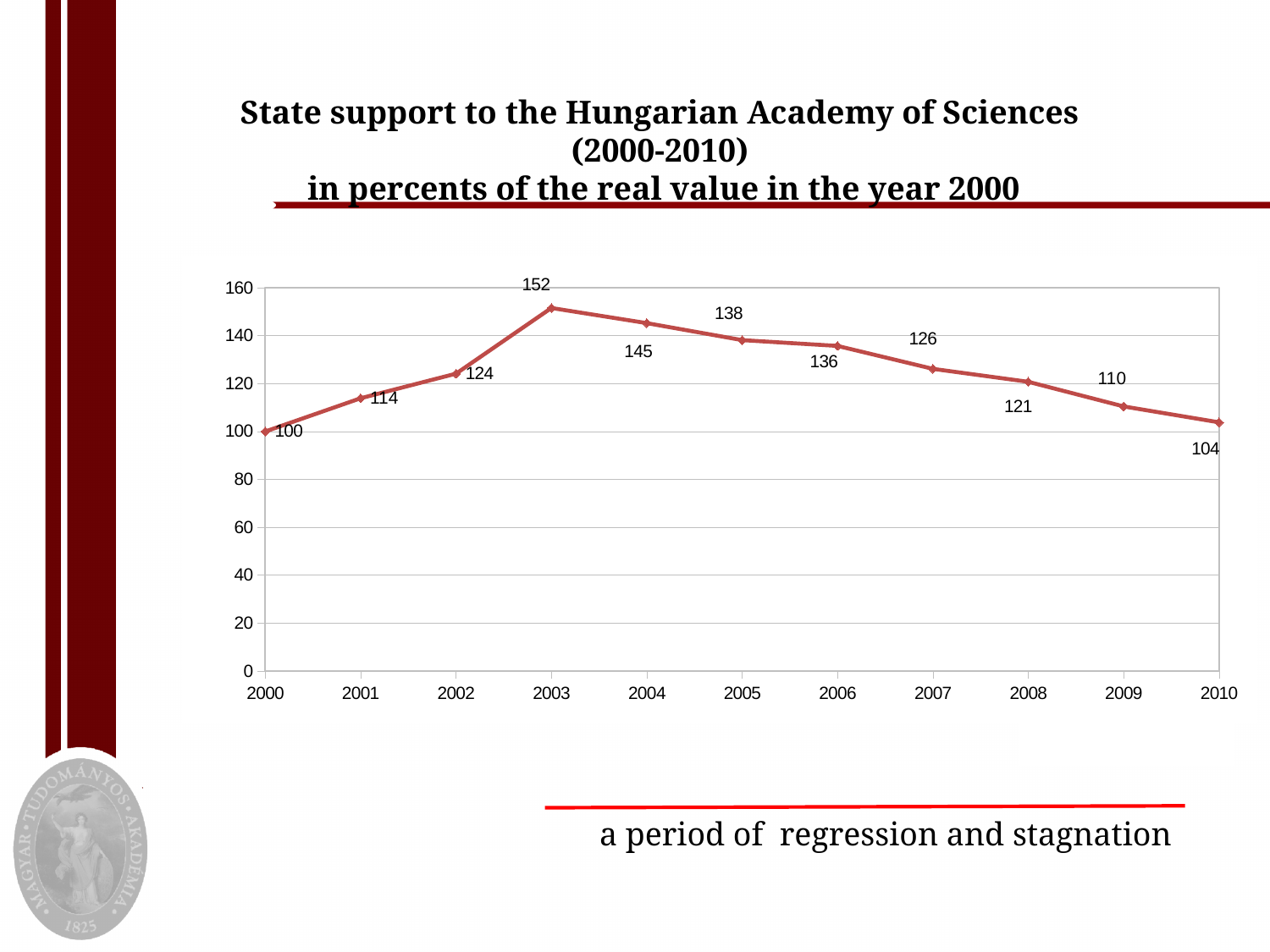
What is the difference between the values for 2004 and 2005? 7 What is the difference between the values for 2003 and 2010? 48 What kind of chart is shown on the slide? line chart What is the value for 2010? 104 How many years are plotted on the chart? 11 Is the value for 2007 greater or less than 120? greater Which year has the highest value? 2003 What is the value for 2003? 152 What is the value for 2006? 136 Do the values rise or fall from 2003 to 2010? fall Which year has the lowest value? 2000 Which is larger, the value for 2002 or the value for 2008? 2002